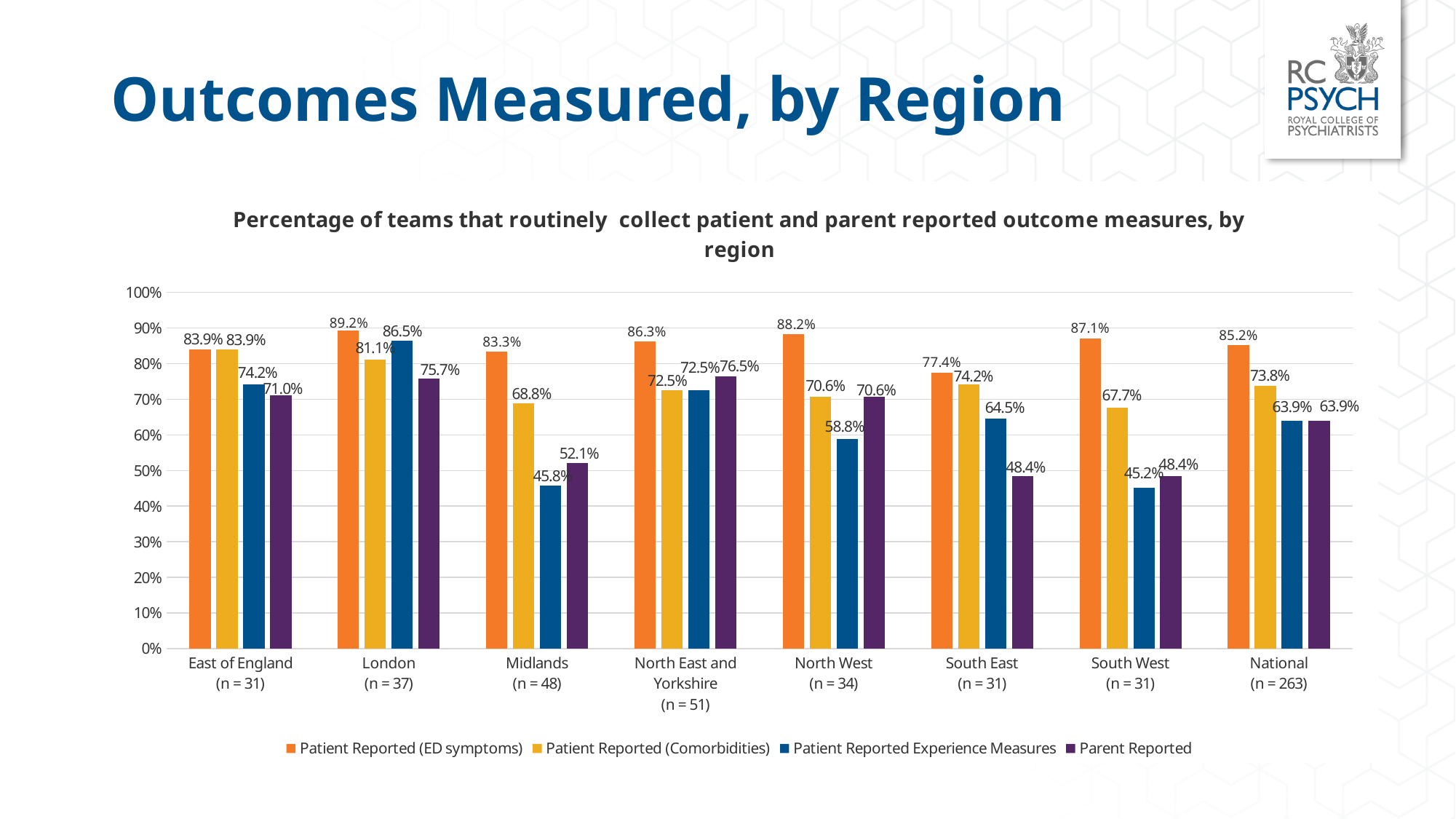
How many series does the legend list? 4 What kind of chart is shown on the slide? Bar chart In the Midlands, which is larger: Patient Reported Experience Measures or Parent Reported? Parent Reported What is the difference between the Patient Reported (ED symptoms) and Parent Reported values for London? 13.5 percentage points What is the Patient Reported Experience Measures value for South West? 45.2% What percentage of Midlands teams routinely collect Parent Reported outcome measures? 52.1% What colour represents the Parent Reported series in the legend? Purple What is the National value for Patient Reported (Comorbidities)? 73.8% How many regions (categories) are shown on the x axis? 8 Which region has the highest value for Patient Reported (ED symptoms)? London What is the value for Patient Reported (ED symptoms) in London? 89.2% Which region has the lowest value for Patient Reported (Comorbidities)? South West